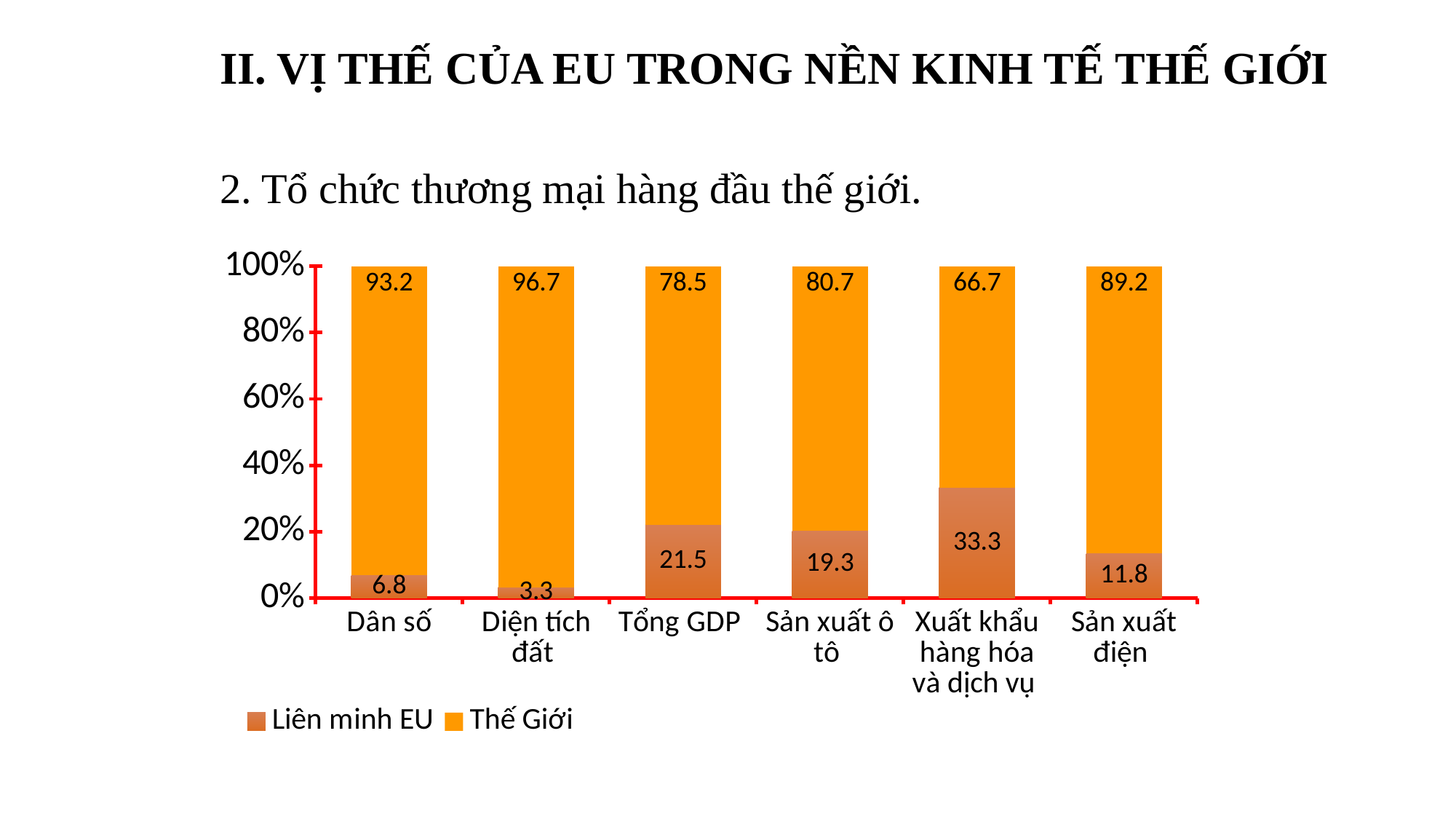
Which series is shown in the darker orange-brown colour? Liên minh EU What is the value for Liên minh EU in the Xuất khẩu hàng hóa và dịch vụ category? 33.3 Which category has the highest value for Thế Giới? Diện tích đất How many series does the legend list? 2 Which category has the highest value for Liên minh EU? Xuất khẩu hàng hóa và dịch vụ What is the value for Thế Giới in the Dân số category? 93.2 How many categories are shown on the x axis? 6 What kind of chart is shown on the slide? Stacked bar chart What is the difference between the Liên minh EU values for Tổng GDP and Sản xuất ô tô? 2.2 What is the value for Liên minh EU in the Tổng GDP category? 21.5 Which category has the lowest value for Liên minh EU? Diện tích đất Which is larger for Liên minh EU: Sản xuất điện or Dân số? Sản xuất điện